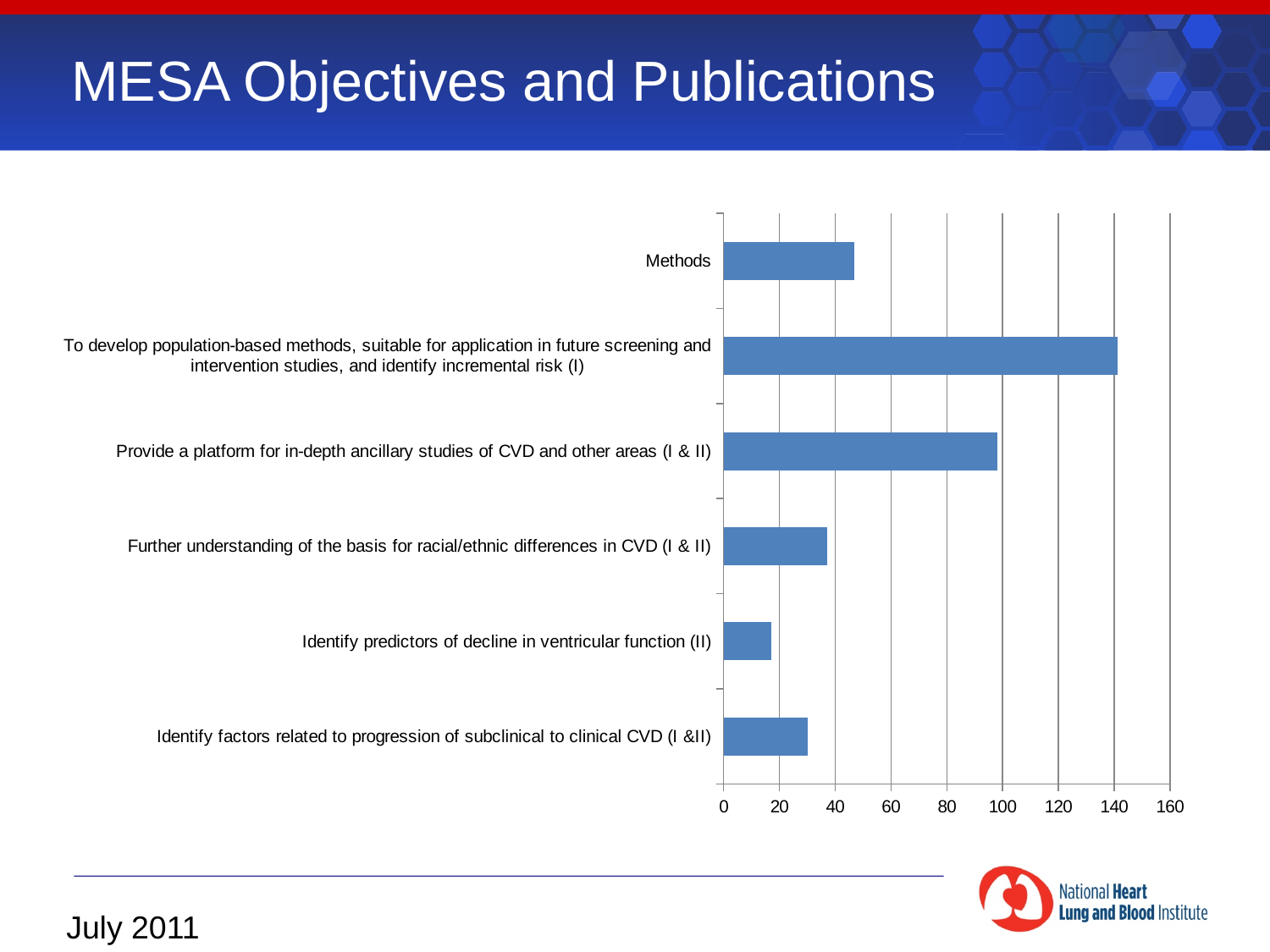
Which is larger: the value for Methods or the value for 'Further understanding of the basis for racial/ethnic differences in CVD (I & II)'? Methods Which is larger: the value for 'Provide a platform for in-depth ancillary studies of CVD and other areas (I & II)' or the value for Methods? Provide a platform for in-depth ancillary studies of CVD and other areas (I & II) Which category has the lowest value? Identify predictors of decline in ventricular function (II) Is the value for Methods greater or less than 40? greater How many categories (bars) does the chart show? 6 Is the value for 'Provide a platform for in-depth ancillary studies of CVD and other areas (I & II)' greater or less than 80? greater Is the value for 'To develop population-based methods, suitable for application in future screening and intervention studies, and identify incremental risk (I)' greater or less than 120? greater What kind of chart is shown on the slide? bar chart Which category has the highest value? To develop population-based methods, suitable for application in future screening and intervention studies, and identify incremental risk (I) What is the highest tick value shown on the horizontal axis? 160